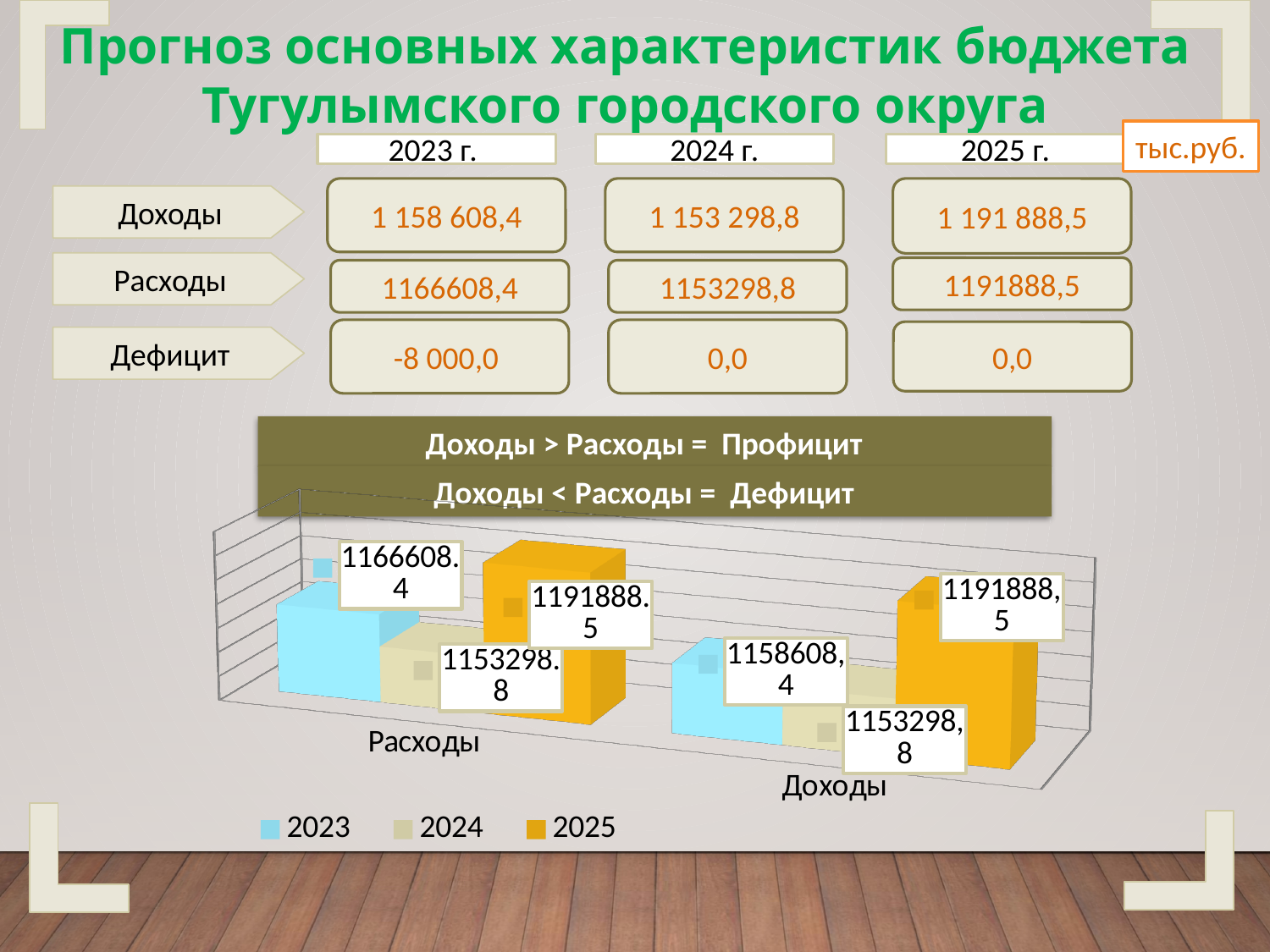
What is the difference between the 2025 and 2023 values for Доходы in the chart? 33280,1 What is the difference between the 2025 and 2024 values for Расходы in the chart? 38589.7 Which series is shown in orange in the chart legend? 2025 What is the value of the 2024 bar for Доходы in the chart? 1153298,8 What is the value of the 2023 bar for Расходы in the chart? 1166608.4 What is the value of the 2025 bar for Доходы in the chart? 1191888,5 In the chart, which is larger for 2023: Расходы or Доходы? Расходы Which year has the lowest bar for Доходы in the chart? 2024 How many categories are shown on the x axis of the chart? 2 How many series does the chart legend list? 3 What kind of chart is shown on the slide? bar chart Which year has the highest bar for Расходы in the chart? 2025